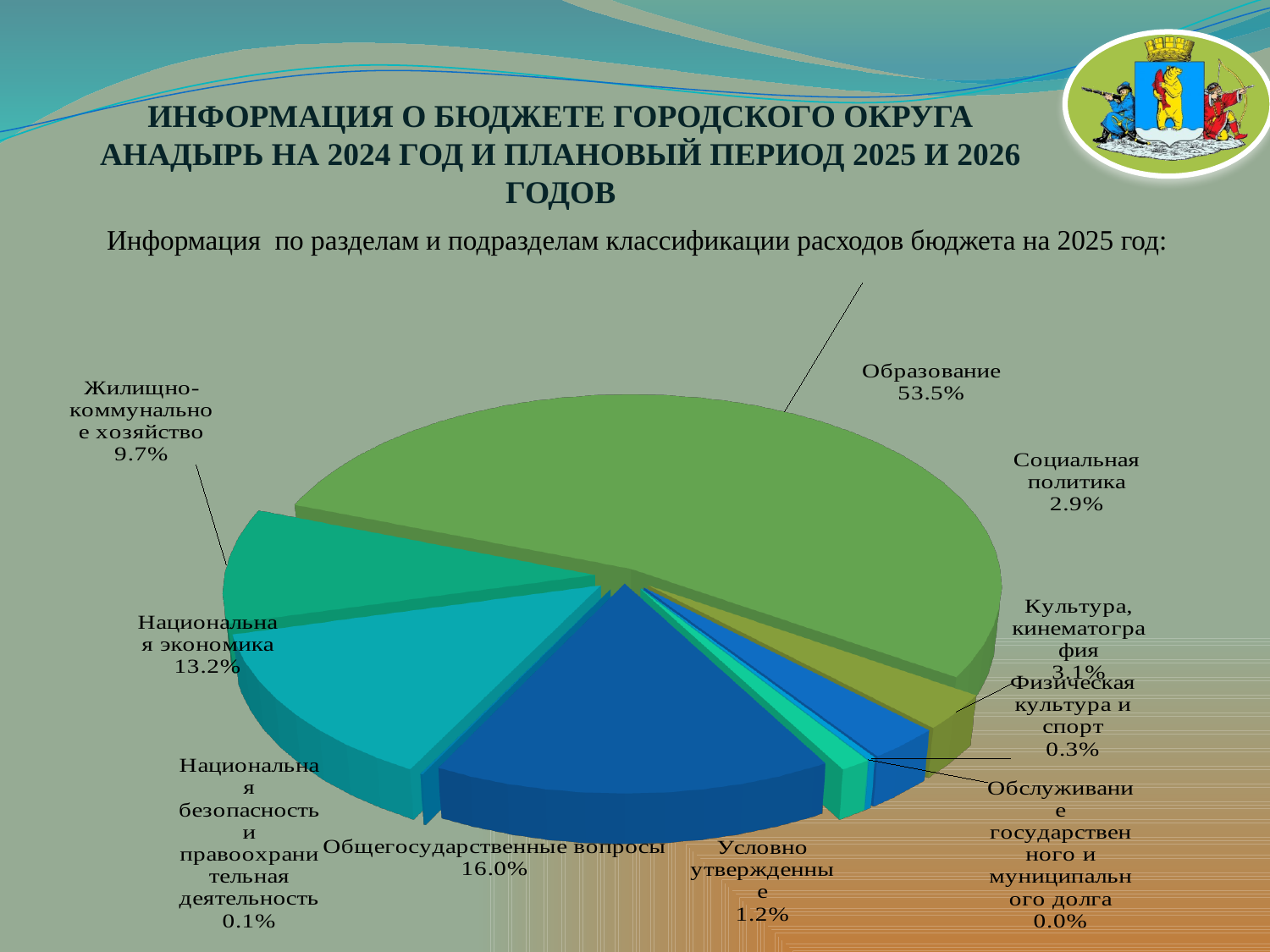
How many categories are shown in the pie chart? 10 What percentage is shown for Общегосударственные вопросы? 16.0% What type of chart is shown on the slide? pie chart Which category has the largest share of the pie? Образование What percentage is shown for Жилищно-коммунальное хозяйство? 9.7% Which is larger: the share for Культура, кинематография or the share for Социальная политика? Культура, кинематография What percentage is shown for Условно утвержденные? 1.2% What is the difference in percentage points between Общегосударственные вопросы and Национальная экономика? 2.8 Which category has the smallest share of the pie? Обслуживание государственного и муниципального долга What percentage is shown for Национальная экономика? 13.2% What is the combined share of Образование and Общегосударственные вопросы? 69.5% What share of the 2025 budget expenditures goes to Образование? 53.5%